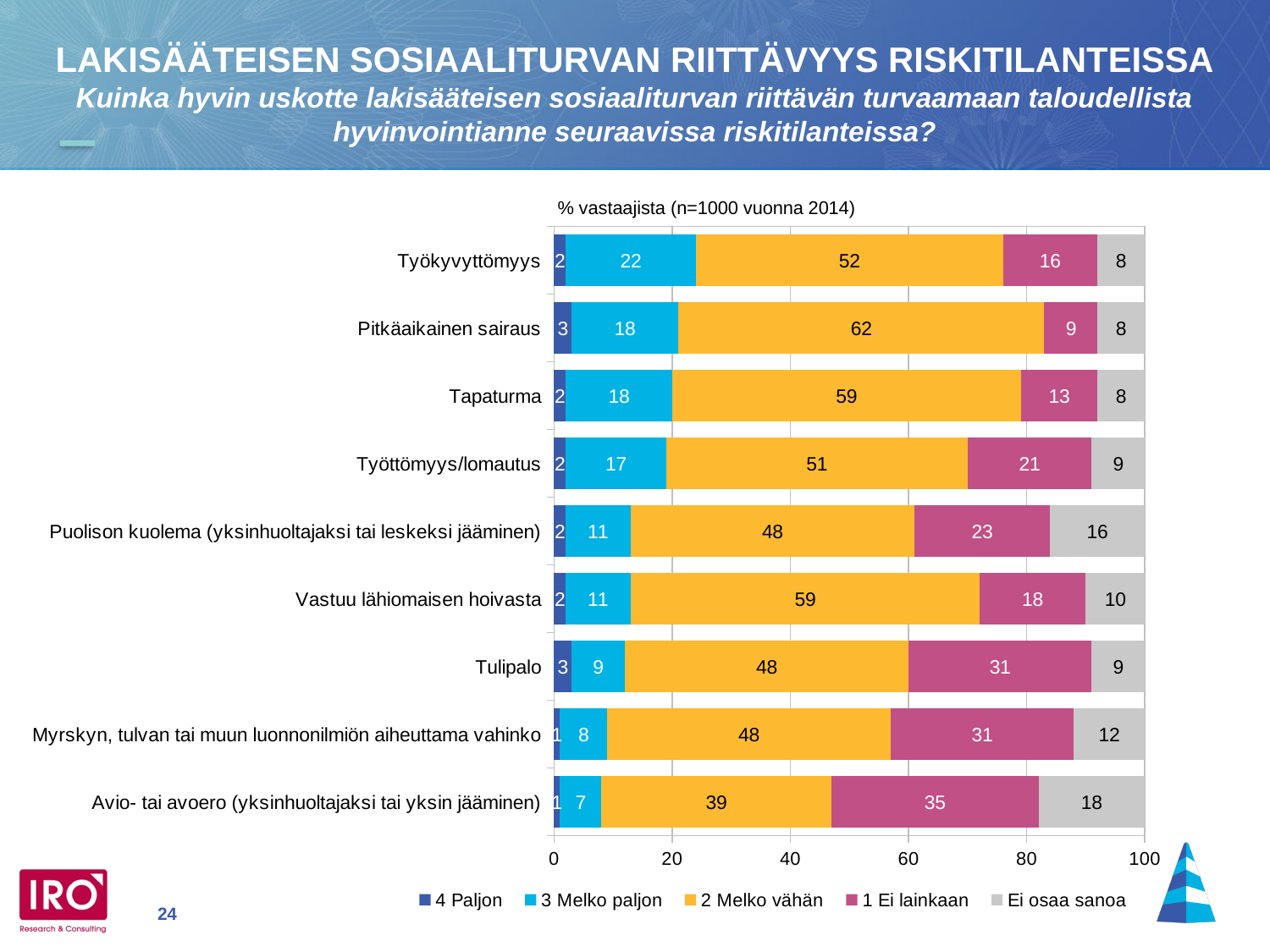
What is the text shown above the chart describing the values? % vastaajista (n=1000 vuonna 2014) Which has the larger "Ei osaa sanoa" value: Puolison kuolema or Avio- tai avoero? Avio- tai avoero (yksinhuoltajaksi tai yksin jääminen) Which category has the lowest value for "3 Melko paljon"? Avio- tai avoero (yksinhuoltajaksi tai yksin jääminen) What is the value of "2 Melko vähän" for Pitkäaikainen sairaus? 62 How many categories are shown on the chart? 9 What kind of chart is shown on the slide? Stacked bar chart What is the difference between the "1 Ei lainkaan" values for Tulipalo and Työkyvyttömyys? 15 How many series does the legend list? 5 What is the value of "3 Melko paljon" for Työkyvyttömyys? 22 What is the value of "1 Ei lainkaan" for Avio- tai avoero (yksinhuoltajaksi tai yksin jääminen)? 35 What is the total of the stacked bar for Työttömyys/lomautus? 100 Which category has the highest value for "2 Melko vähän"? Pitkäaikainen sairaus